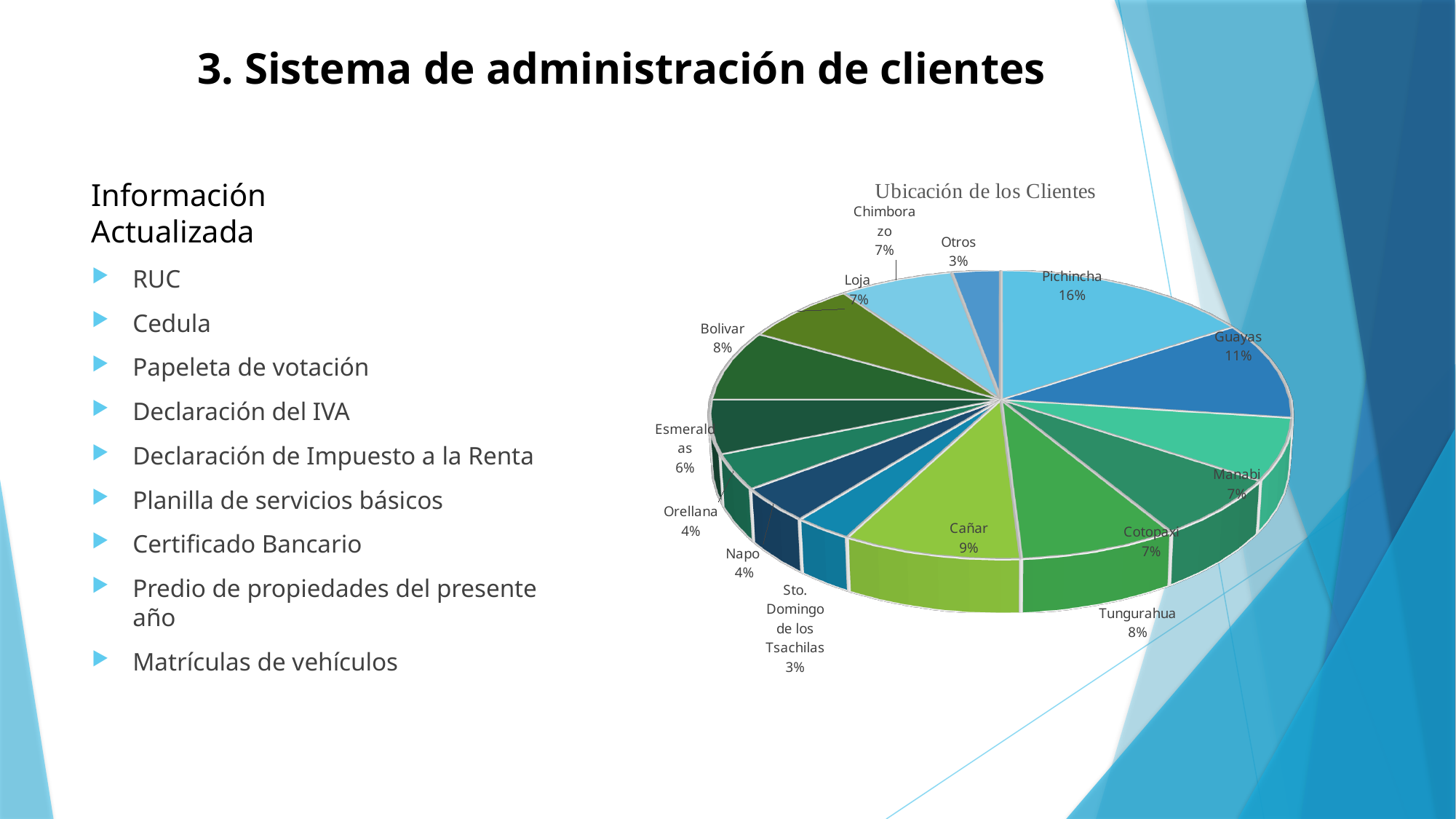
How many slices does the pie chart have? 14 What type of chart is shown on the slide? Pie chart What percentage is shown for Esmeraldas? 6% What percentage is shown for Cañar? 9% What share of clients is located in Pichincha? 16% What share of clients is located in Guayas? 11% What is the title of the chart? Ubicación de los Clientes What percentage is shown for Sto. Domingo de los Tsachilas? 3% Which province has the largest share of clients? Pichincha What is the difference in percentage points between Pichincha and Guayas? 5 What is the difference in percentage points between Bolivar and Orellana? 4 Which has a larger share, Tungurahua or Napo? Tungurahua